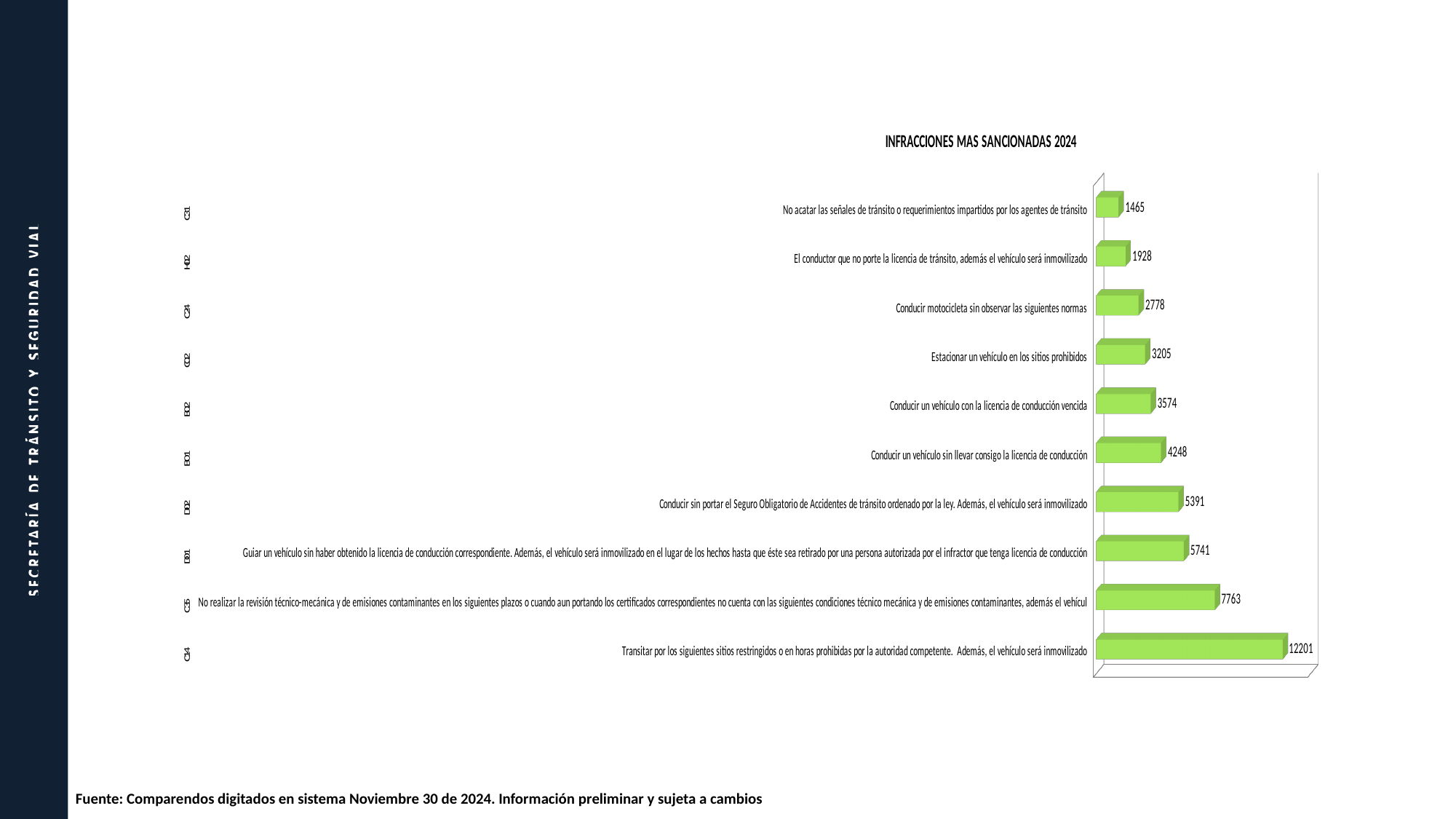
What is the difference between the value for "Conducir un vehículo con la licencia de conducción vencida" and the value for "El conductor que no porte la licencia de tránsito, además el vehículo será inmovilizado"? 1646 What is the value for "Estacionar un vehículo en los sitios prohibidos"? 3205 What is the value for "Conducir un vehículo sin llevar consigo la licencia de conducción"? 4248 What is the value for "Conducir motocicleta sin observar las siguientes normas"? 2778 How many infraction categories are plotted in the chart? 10 Which is larger: the value for "Conducir sin portar el Seguro Obligatorio de Accidentes de tránsito ordenado por la ley. Además, el vehículo será inmovilizado" or the value for "Guiar un vehículo sin haber obtenido la licencia de conducción correspondiente..."? Guiar un vehículo sin haber obtenido la licencia de conducción correspondiente... What is the value for "No realizar la revisión técnico-mecánica y de emisiones contaminantes..."? 7763 What is the title of the chart? INFRACCIONES MAS SANCIONADAS 2024 What is the value for "Transitar por los siguientes sitios restringidos o en horas prohibidas por la autoridad competente. Además, el vehículo será inmovilizado"? 12201 What type of chart is shown on the slide? bar chart Which infraction has the lowest value in the chart? No acatar las señales de tránsito o requerimientos impartidos por los agentes de tránsito Which infraction has the highest value in the chart? Transitar por los siguientes sitios restringidos o en horas prohibidas por la autoridad competente. Además, el vehículo será inmovilizado